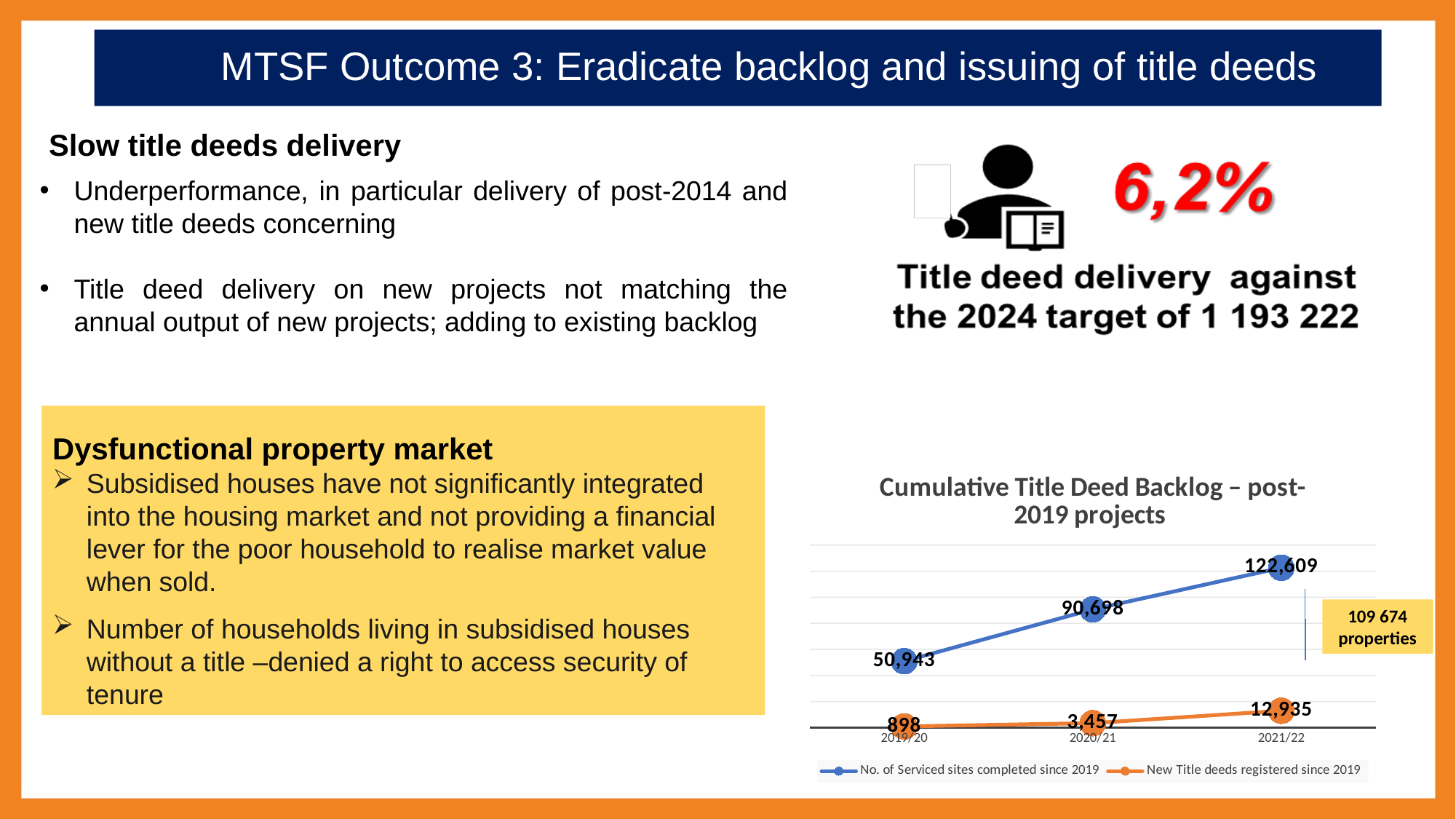
What is the value for New Title deeds registered since 2019 in 2020/21? 3,457 What is the difference between the 2020/21 and 2019/20 values for No. of Serviced sites completed since 2019? 39,755 What is the value for New Title deeds registered since 2019 in 2021/22? 12,935 Which is larger in 2020/21: No. of Serviced sites completed since 2019 or New Title deeds registered since 2019? No. of Serviced sites completed since 2019 Do the values for New Title deeds registered since 2019 rise or fall from 2019/20 to 2021/22? Rise In which year is the value for No. of Serviced sites completed since 2019 highest? 2021/22 How many series does the legend list? 2 What is the value for No. of Serviced sites completed since 2019 in 2021/22? 122,609 What kind of chart is shown? Line chart In which year is the value for New Title deeds registered since 2019 lowest? 2019/20 What is the difference between No. of Serviced sites completed since 2019 and New Title deeds registered since 2019 in 2021/22? 109,674 What is the value for No. of Serviced sites completed since 2019 in 2019/20? 50,943